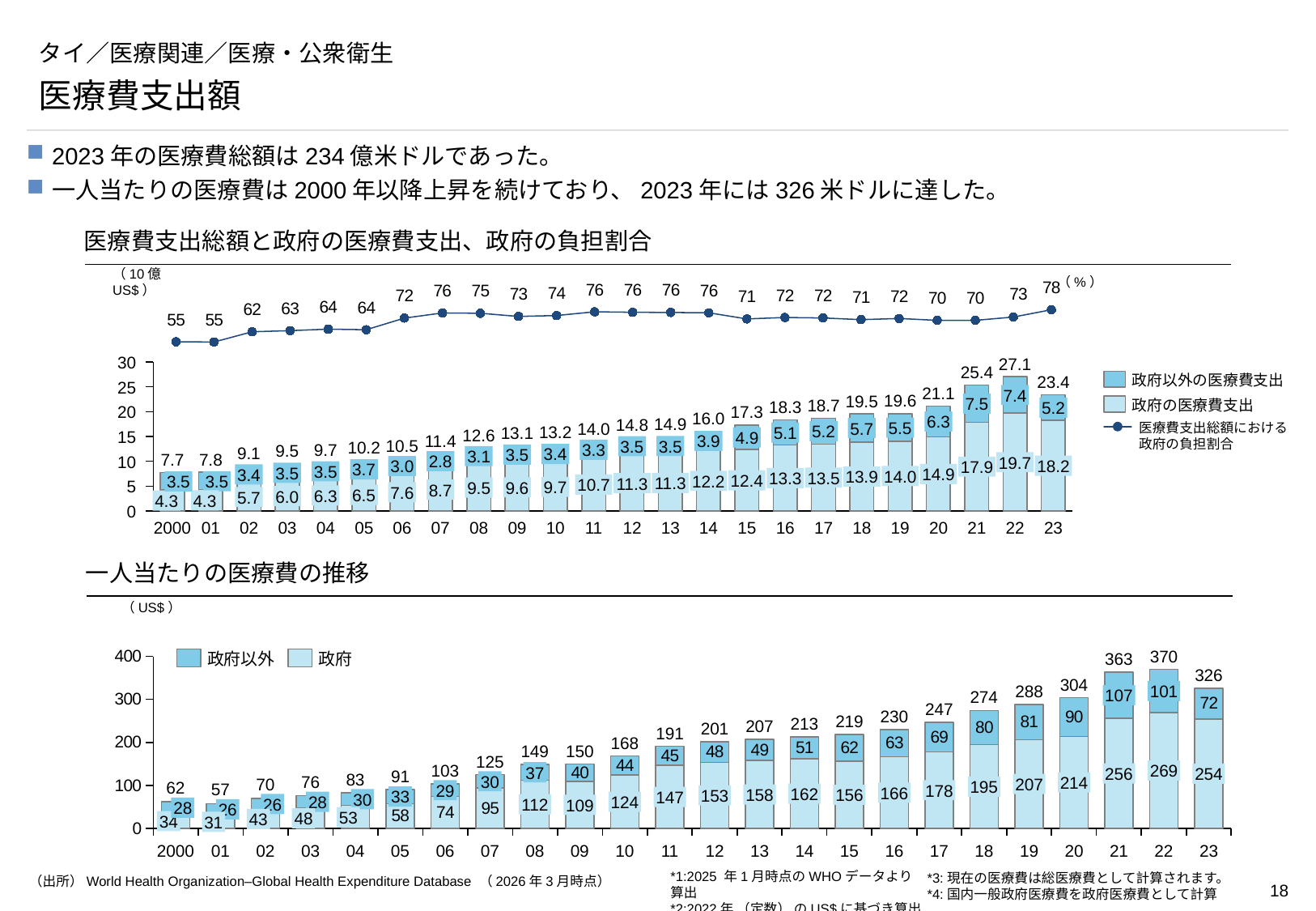
In the chart titled 一人当たりの医療費の推移, what is the per-capita health expenditure (US$) for 2023? 326 In the chart titled 一人当たりの医療費の推移, which year has the lowest per-capita health expenditure? 01 In the chart titled 一人当たりの医療費の推移, how many years are shown on the x axis? 24 In the chart titled 医療費支出総額と政府の医療費支出、政府の負担割合, what is the total health expenditure (10億US$) for 2023? 23.4 In the chart titled 医療費支出総額と政府の医療費支出、政府の負担割合, what is the government share (%) of total health expenditure in 2023? 78 In the chart titled 医療費支出総額と政府の医療費支出、政府の負担割合, how many entries does the legend list? 3 In the chart titled 一人当たりの医療費の推移, what is the 政府 (government) value for 2023? 254 In the chart titled 一人当たりの医療費の推移, what is the difference between the per-capita total in 2022 and in 2023? 44 In the chart titled 医療費支出総額と政府の医療費支出、政府の負担割合, which year has the highest total health expenditure? 22 In the chart titled 医療費支出総額と政府の医療費支出、政府の負担割合, what is the government health expenditure (政府の医療費支出) for 2000? 4.3 In the chart titled 一人当たりの医療費の推移, which year has the highest per-capita health expenditure? 22 In the chart titled 医療費支出総額と政府の医療費支出、政府の負担割合, what is the difference between the total health expenditure in 2022 and in 2023? 3.7